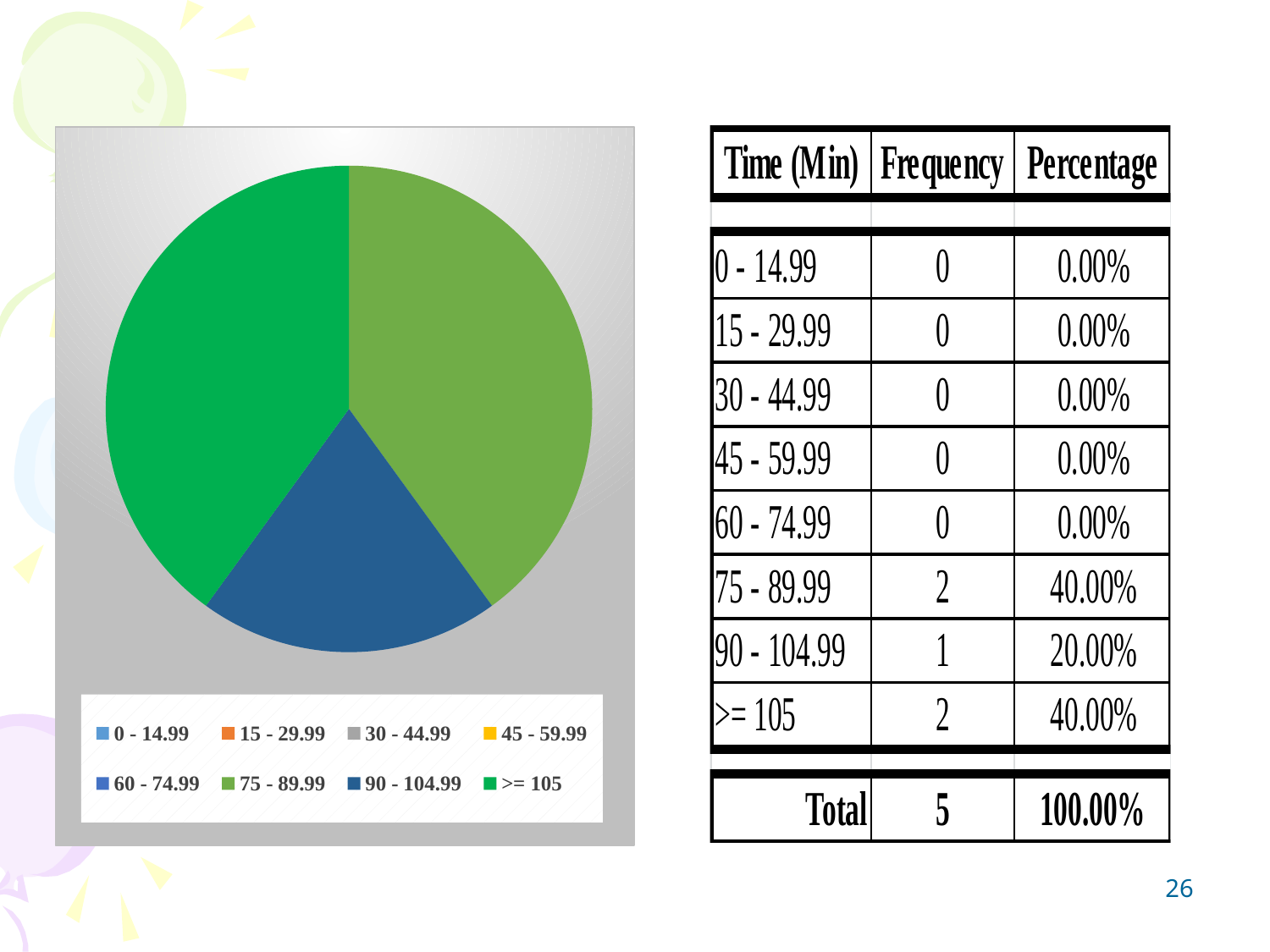
What colour is the 90 - 104.99 slice in the pie chart? dark blue According to the table, what percentage share does the 90 - 104.99 slice of the pie chart represent? 20.00% What kind of chart is shown on the left of the slide? pie chart In the pie chart, which slice is larger: 75 - 89.99 or 90 - 104.99? 75 - 89.99 In the pie chart, which slice is larger: >= 105 or 90 - 104.99? >= 105 According to the table, what is the total frequency across all categories? 5 According to the table, what percentage share does the >= 105 slice of the pie chart represent? 40.00% How many categories does the pie chart's legend list? 8 Which of the visible slices in the pie chart is the smallest? 90 - 104.99 According to the table, what is the frequency for the 75 - 89.99 category? 2 What is the column header for the first column of the table next to the pie chart? Time (Min) How many slices are visible in the pie chart? 3